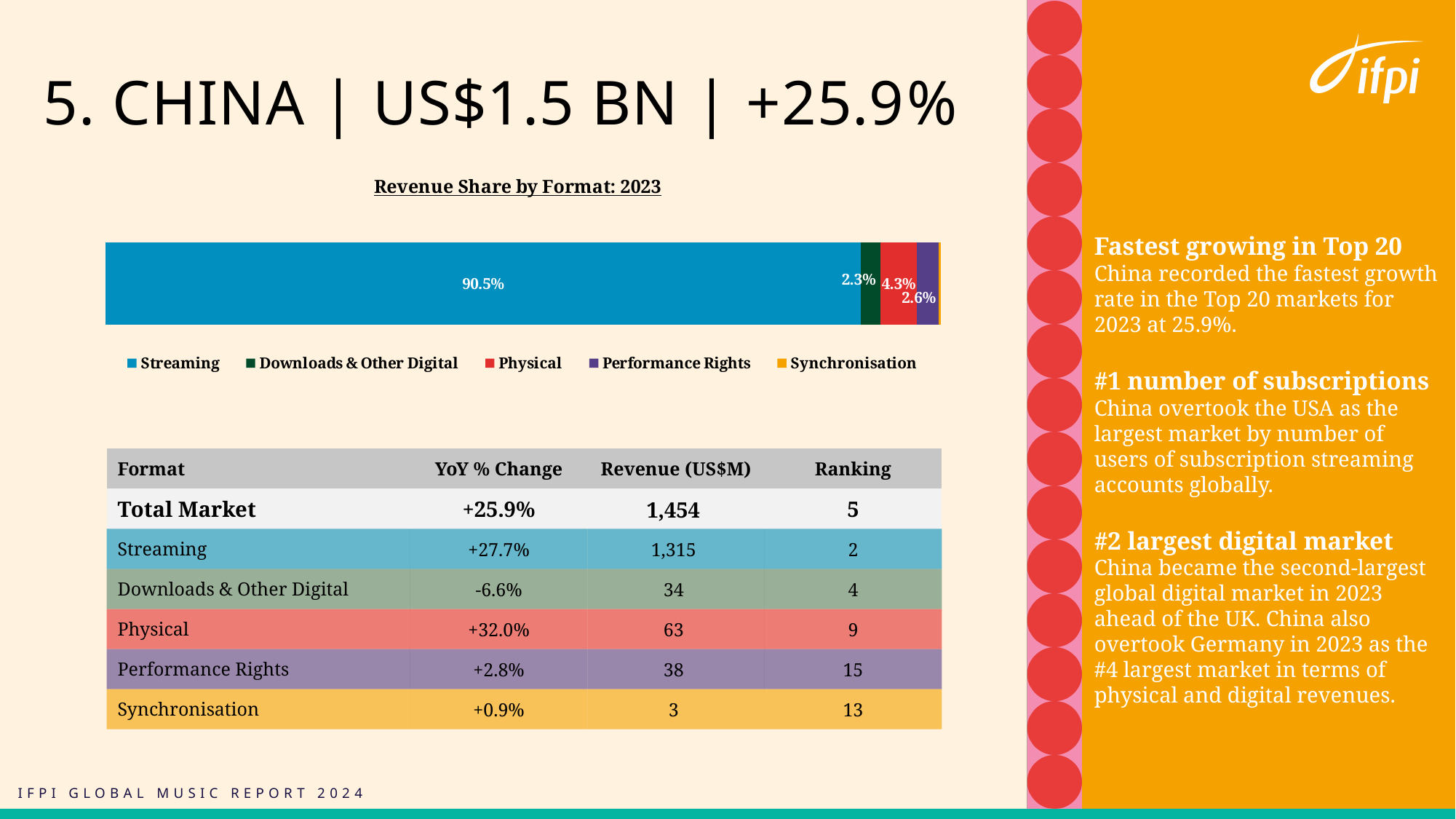
In the Revenue Share by Format: 2023 chart, which has a larger share: Physical or Downloads & Other Digital? Physical In the Revenue Share by Format: 2023 chart, how many percentage points larger is the Streaming share than the Physical share? 86.2 percentage points What is the revenue share for Performance Rights in the Revenue Share by Format: 2023 chart? 2.6% How many series does the legend of the Revenue Share by Format: 2023 chart list? 5 Which format has the largest revenue share in the Revenue Share by Format: 2023 chart? Streaming What is the revenue share for Downloads & Other Digital in the Revenue Share by Format: 2023 chart? 2.3% What type of chart is the Revenue Share by Format: 2023 chart? Stacked bar chart In the Revenue Share by Format: 2023 chart, how many percentage points larger is the Physical share than the Performance Rights share? 1.7 percentage points What is the revenue share for Physical in the Revenue Share by Format: 2023 chart? 4.3% What is the revenue share for Streaming in the Revenue Share by Format: 2023 chart? 90.5% Which format has the smallest revenue share in the Revenue Share by Format: 2023 chart? Synchronisation What colour represents Synchronisation in the Revenue Share by Format: 2023 chart? Orange